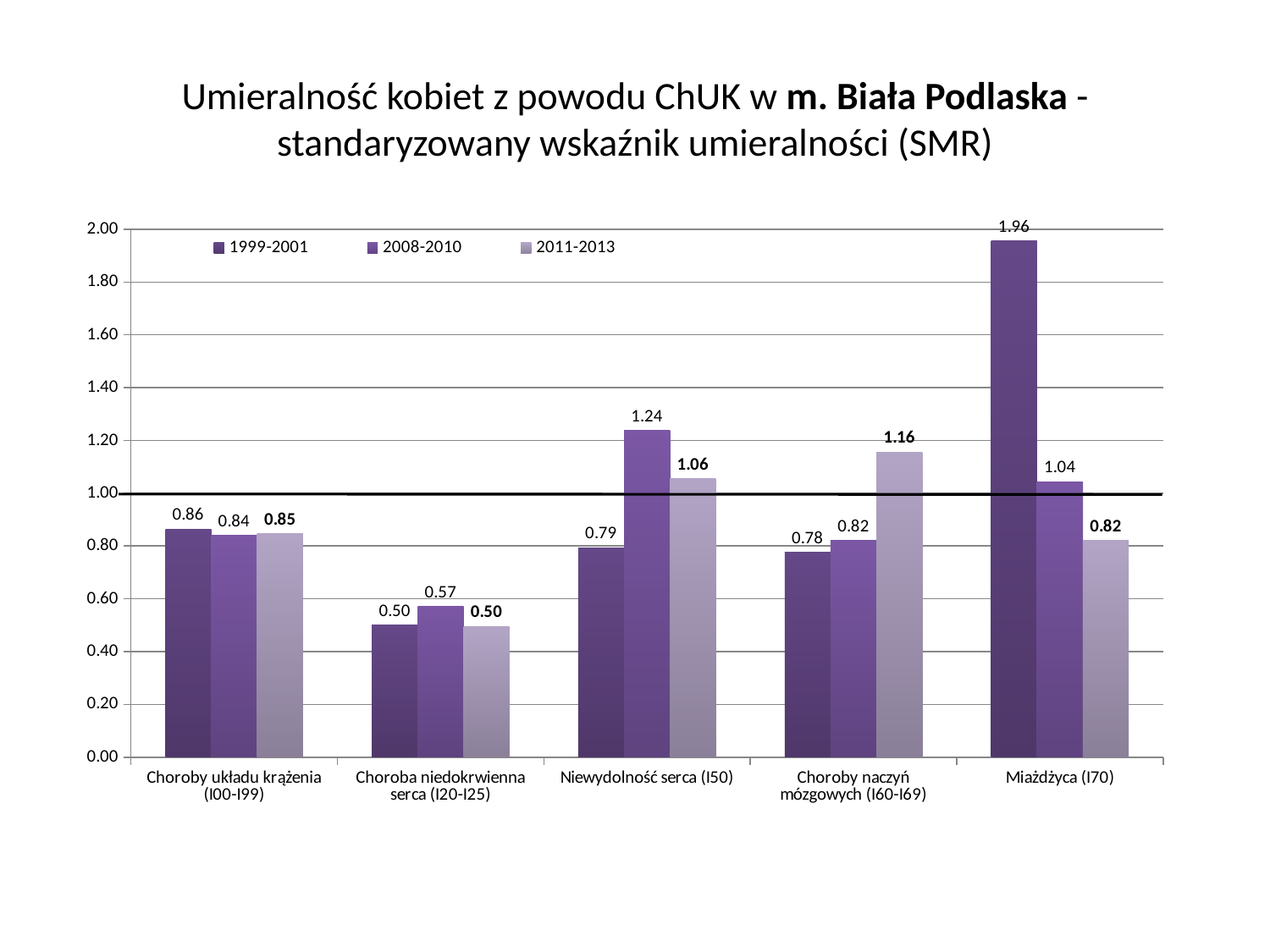
How many series does the legend list? 3 Which category has the highest value in the 1999-2001 series? Miażdżyca (I70) What kind of chart is shown on the slide? bar chart Is the 2011-2013 value for Choroby naczyń mózgowych (I60-I69) greater or less than 1.00? greater What is the difference between the 1999-2001 and 2011-2013 values for Miażdżyca (I70)? 1.14 Which category has the lowest value in the 2011-2013 series? Choroba niedokrwienna serca (I20-I25) Which is larger for Niewydolność serca (I50): the 2008-2010 value or the 2011-2013 value? 2008-2010 How many categories are shown on the x axis? 5 What is the value for Choroby naczyń mózgowych (I60-I69) in the 2011-2013 series? 1.16 What is the value for Niewydolność serca (I50) in the 2008-2010 series? 1.24 What is the value for Miażdżyca (I70) in the 1999-2001 series? 1.96 Do the values for Miażdżyca (I70) rise or fall from the 1999-2001 series to the 2011-2013 series? fall